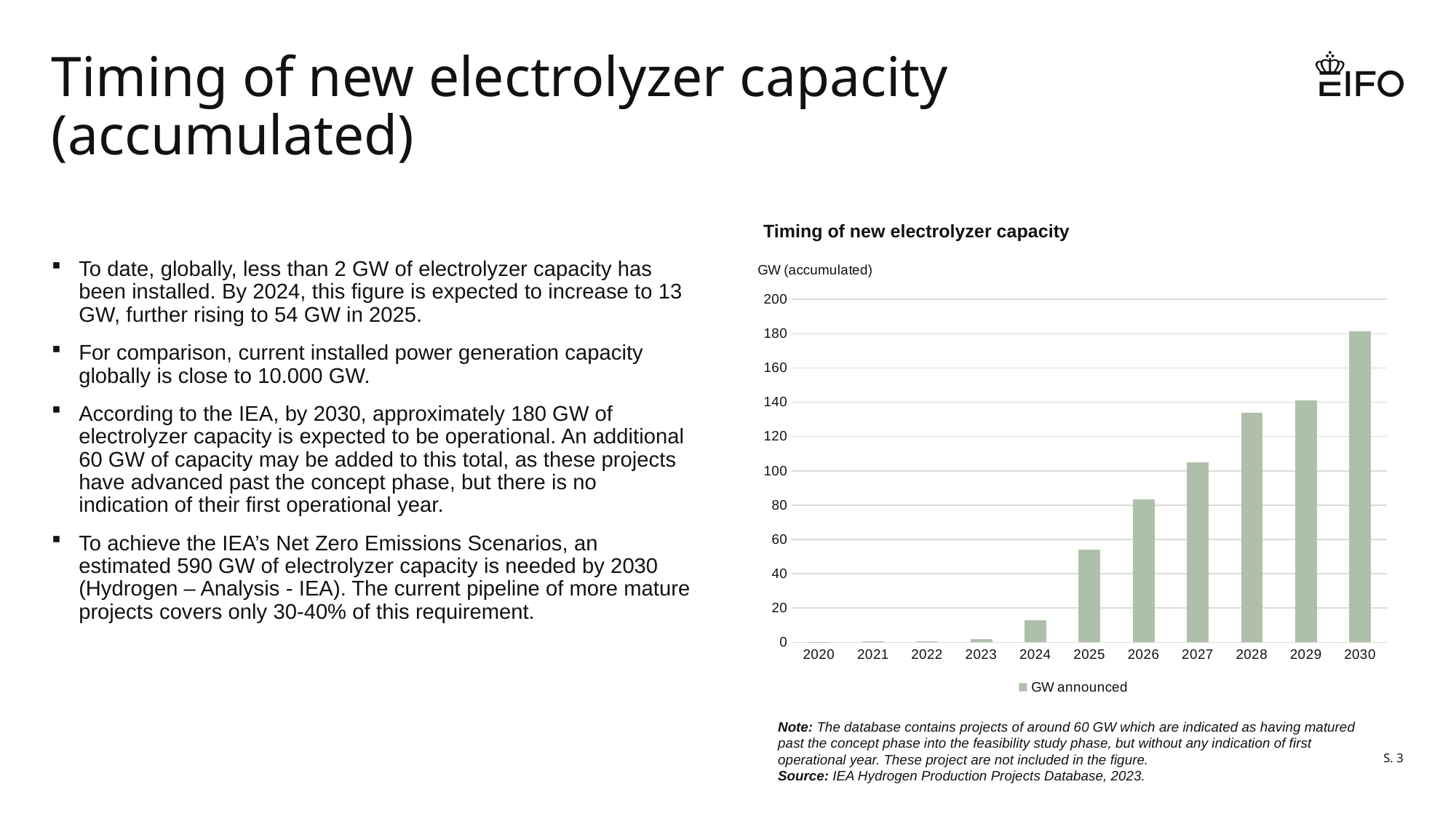
What kind of chart is shown on the slide? bar chart Which year has the highest GW announced value in the chart? 2030 Is the value for 2027 greater or less than 100? greater Is the value for 2028 greater or less than 140? less Is the value for 2025 greater or less than 60? less What is the series name shown in the chart legend? GW announced Do the GW announced values rise or fall from 2020 to 2030? rise How many years are shown on the x axis of the chart? 11 Which year has the larger GW announced value, 2027 or 2028? 2028 How many series does the chart legend list? 1